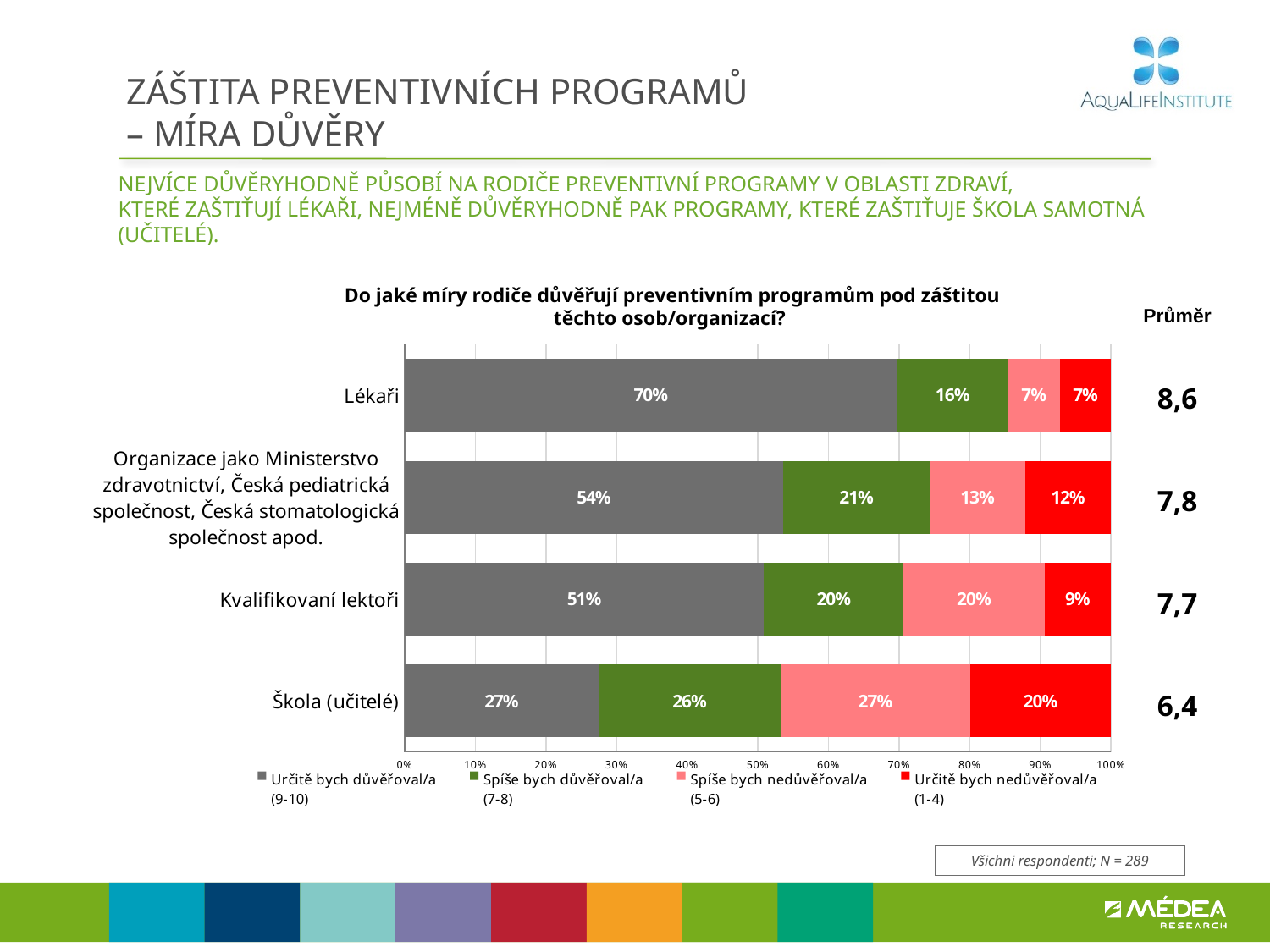
What is the value of 'Určitě bych důvěřoval/a (9-10)' for Lékaři? 70% What is the value of 'Určitě bych nedůvěřoval/a (1-4)' for the category 'Organizace jako Ministerstvo zdravotnictví, Česká pediatrická společnost, Česká stomatologická společnost apod.'? 12% Which is larger: the 'Určitě bych nedůvěřoval/a (1-4)' value for Škola (učitelé) or for Kvalifikovaní lektoři? Škola (učitelé) Which category has the lowest value for 'Určitě bych důvěřoval/a (9-10)'? Škola (učitelé) What is the value of 'Spíše bych důvěřoval/a (7-8)' for Škola (učitelé)? 26% What is the value of 'Spíše bych nedůvěřoval/a (5-6)' for Kvalifikovaní lektoři? 20% How many series does the legend list? 4 What is the difference between the 'Určitě bych důvěřoval/a (9-10)' values for Lékaři and Škola (učitelé)? 43% How many categories are plotted on the chart? 4 What type of chart is shown on the slide? Stacked bar chart What is the Průměr (average) value shown for Lékaři? 8,6 Which category has the highest value for 'Určitě bych důvěřoval/a (9-10)'? Lékaři